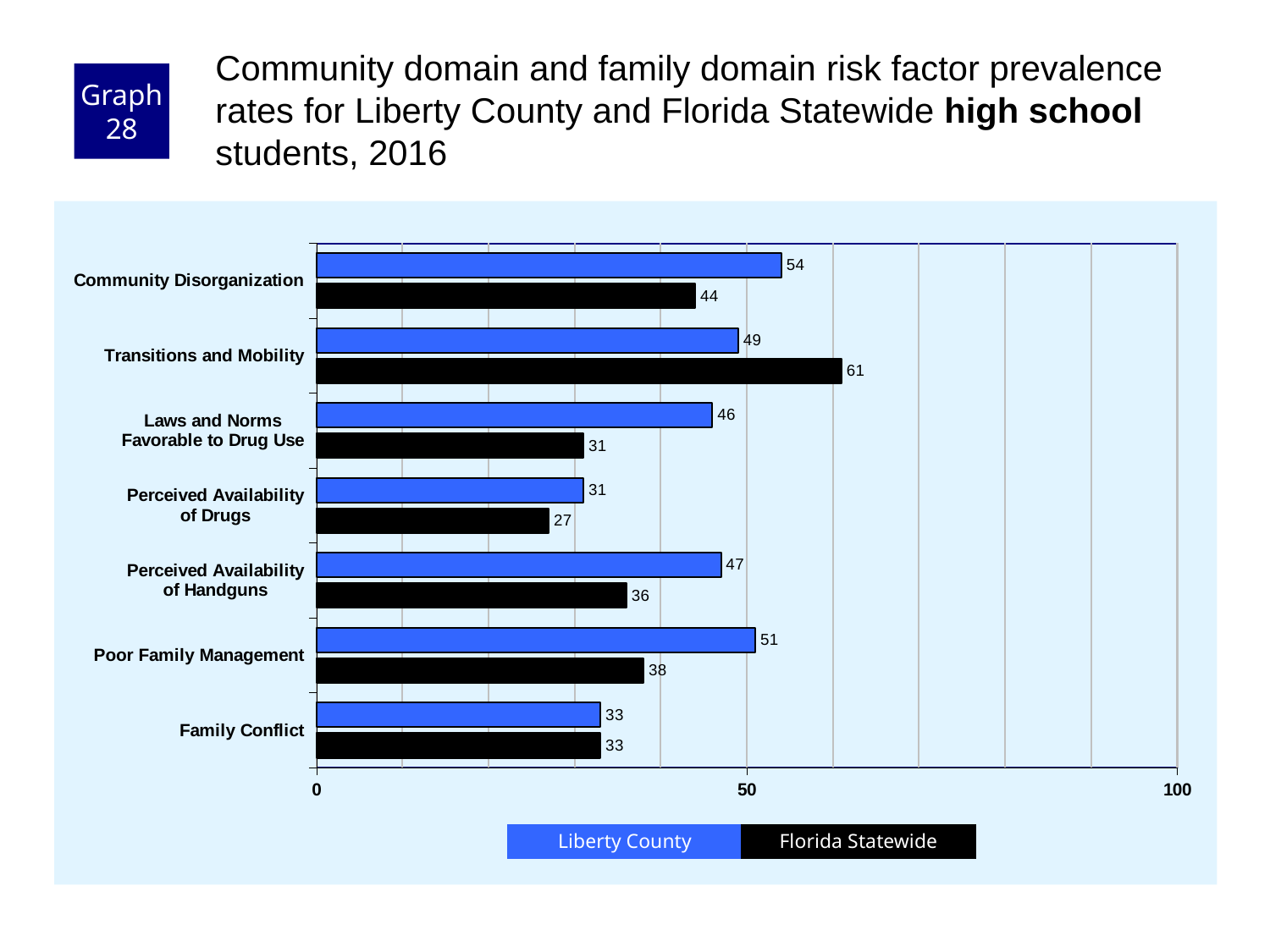
Is the Liberty County value for Poor Family Management greater or less than 50? greater Which colour represents Florida Statewide in the chart? Black What kind of chart is shown on the slide? Bar chart Which is larger for Transitions and Mobility, the Liberty County value or the Florida Statewide value? Florida Statewide How many risk factor categories are shown on the chart? 7 Which risk factor has the highest Liberty County value? Community Disorganization What is the Florida Statewide value for Transitions and Mobility? 61 What is the difference between the Liberty County and Florida Statewide values for Laws and Norms Favorable to Drug Use? 15 What is the Florida Statewide value for Perceived Availability of Drugs? 27 What is the Liberty County value for Community Disorganization? 54 Which risk factor has the lowest Florida Statewide value? Perceived Availability of Drugs How many series does the legend list? 2